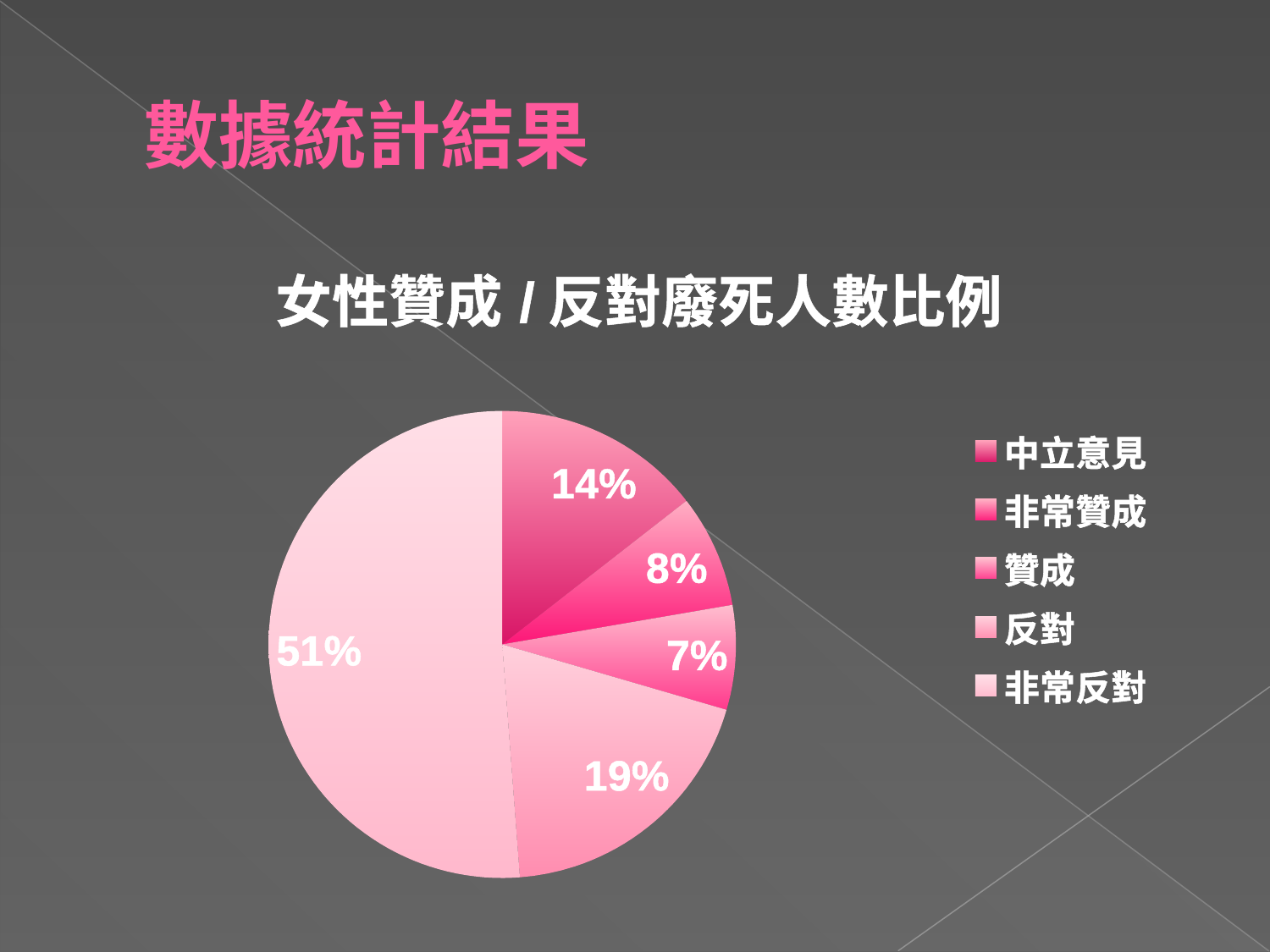
How many slices does the pie chart have? 5 What percentage of the pie is 非常贊成? 8% Which category has the smallest share of the pie? 贊成 How many entries does the legend list? 5 What percentage of the pie is 贊成? 7% What is the difference in percentage points between 非常反對 and 反對? 32 What is the title of the chart? 女性贊成 / 反對廢死人數比例 What percentage of the pie is 中立意見? 14% Which category has the largest share of the pie? 非常反對 What type of chart is shown on the slide? pie chart